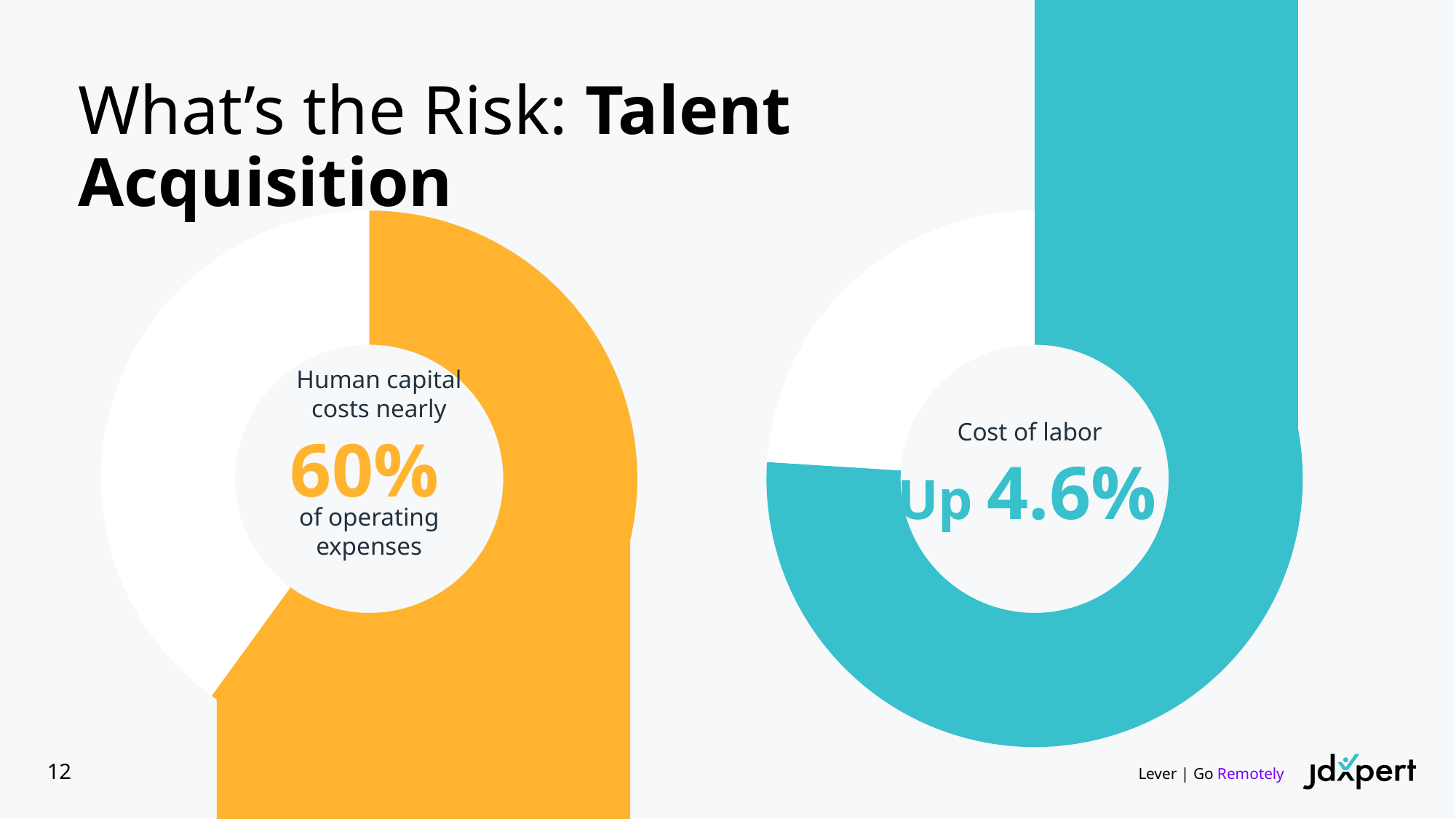
What kind of chart is the left chart showing human capital costs? Donut (pie) chart Which chart shows the larger printed percentage, the left chart (human capital costs) or the right chart (cost of labor)? The left chart (human capital costs) Is the value shown on the left chart for human capital costs greater or less than 50%? greater Is the value shown on the right chart for cost of labor greater or less than 5%? less What label appears in the centre of the right chart above the percentage? Cost of labor On the right chart, by how much has the cost of labor gone up? 4.6% What kind of chart is the right chart showing cost of labor? Donut (pie) chart What is the difference between the percentage on the left chart (60%) and the percentage on the right chart (4.6%)? 55.4 percentage points What colour is the filled portion of the left chart? Orange On the left chart, what share of operating expenses do human capital costs account for? 60% How many donut charts are shown on the slide? 2